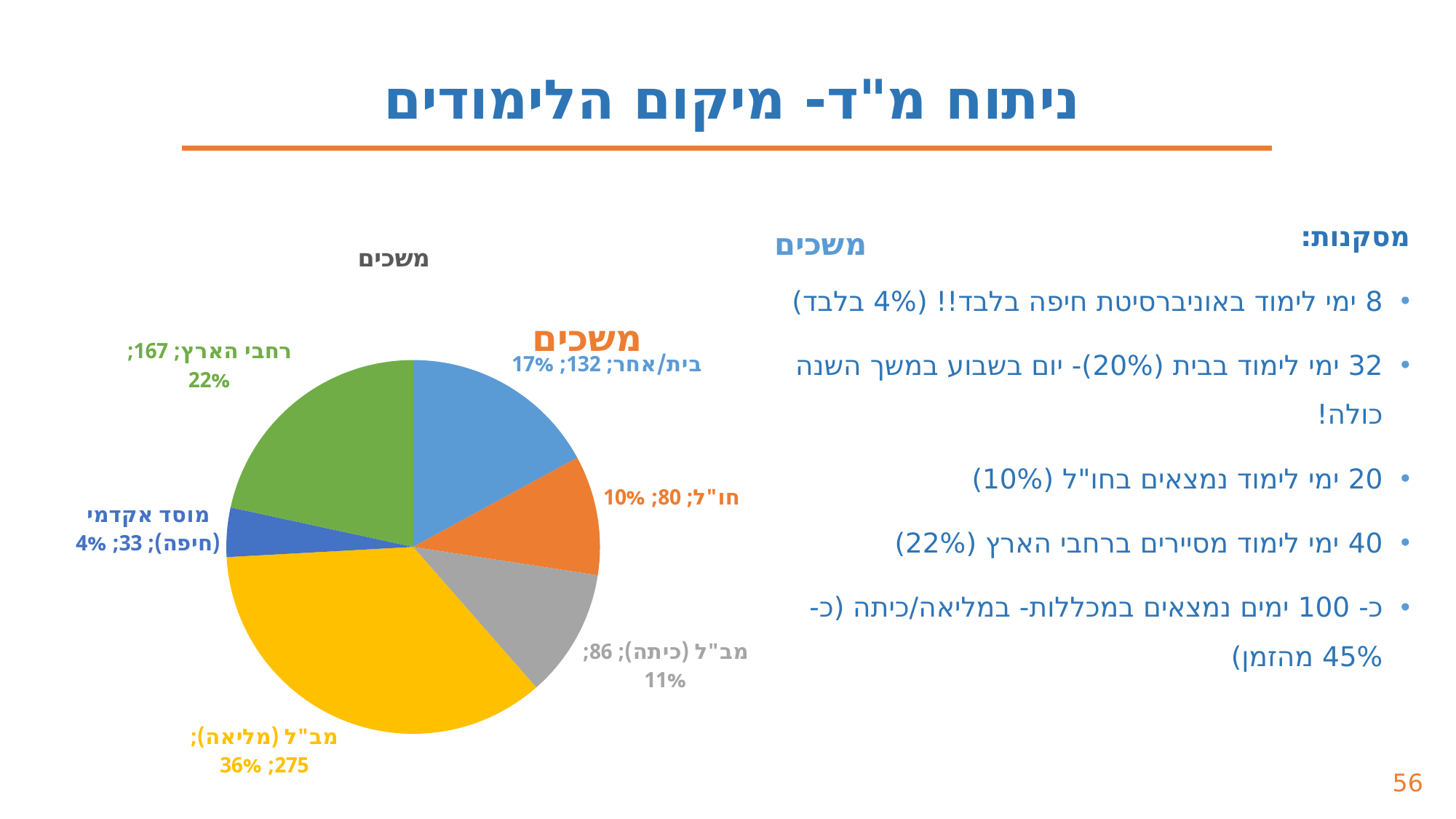
How many slices does the pie chart have? 6 Which slice of the pie chart is the largest? מב"ל (מליאה) Which is larger, the value for מב"ל (כיתה) or the value for חו"ל? מב"ל (כיתה) What value is shown for the slice מב"ל (מליאה)? 275 Which slice of the pie chart is the smallest? מוסד אקדמי (חיפה) What is the difference between the values for רחבי הארץ and בית/אחר? 35 What percentage share is shown for the slice רחבי הארץ? 22% What is the title of the pie chart? משכים What percentage share is shown for the slice בית/אחר? 17% What kind of chart is shown on the slide? pie chart What colour is the slice for מב"ל (מליאה)? yellow What value is shown for the slice חו"ל? 80